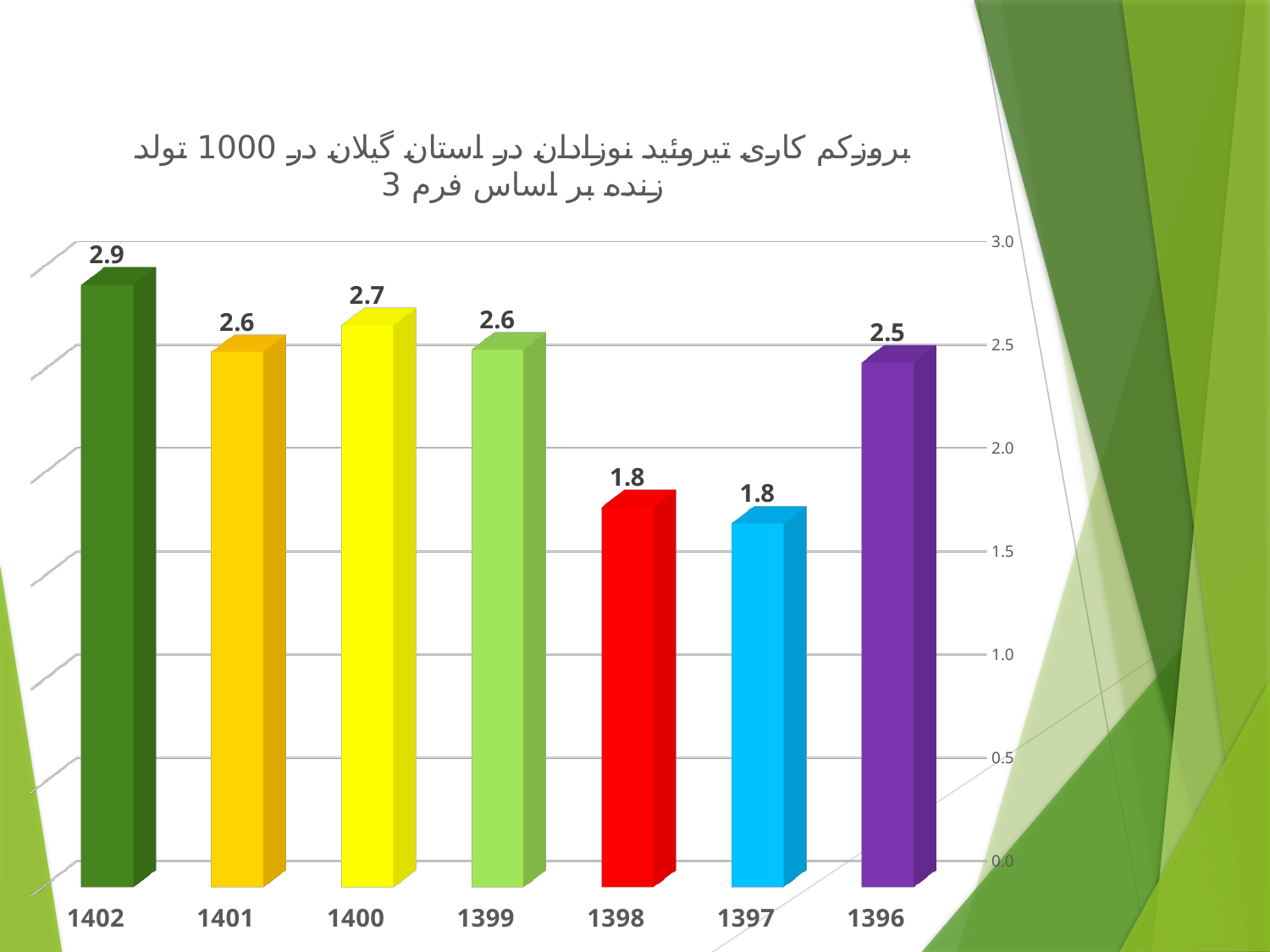
Which has the larger value, 1399 or 1398? 1399 What is the value for 1402? 2.9 What kind of chart is shown on the slide? bar chart How many years are shown on the x axis? 7 What is the value for 1400? 2.7 Is the value for 1396 greater or less than 2.0? greater What is the value for 1398? 1.8 Which has the larger value, 1400 or 1401? 1400 What is the difference between the values for 1400 and 1399? 0.1 What is the value for 1396? 2.5 Which year has the highest value? 1402 What is the difference between the values for 1402 and 1397? 1.1